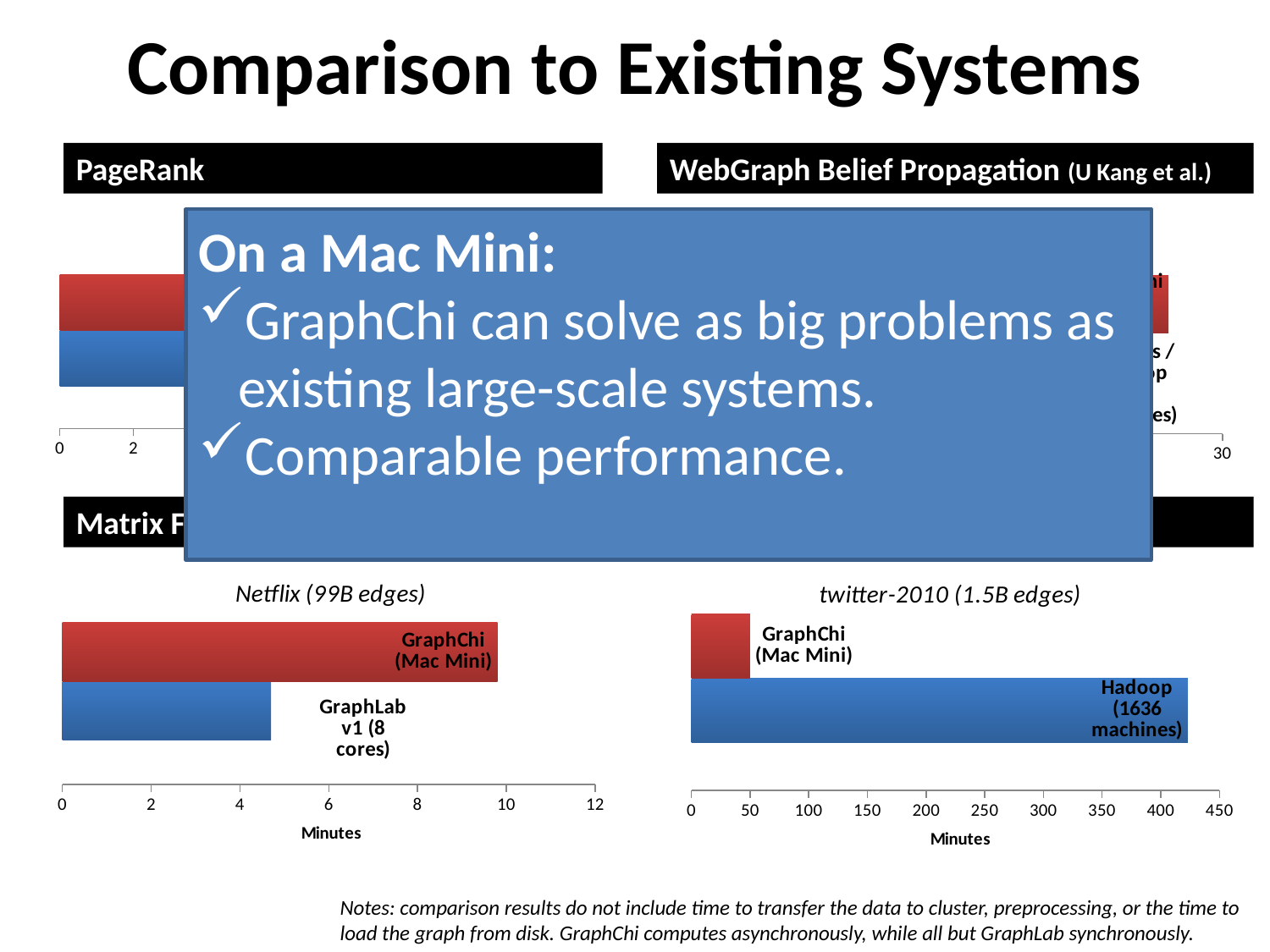
In the twitter-2010 (1.5B edges) chart, which system has the longer bar? Hadoop (1636 machines) What kind of chart is the twitter-2010 (1.5B edges) chart? bar chart In the twitter-2010 (1.5B edges) chart, is the value for GraphChi (Mac Mini) greater or less than 100 minutes? less In the Netflix (99B edges) chart, which system has the longer bar? GraphChi (Mac Mini) What is the x-axis label of the Netflix (99B edges) chart? Minutes How many bars are plotted in the Netflix (99B edges) chart? 2 In the Netflix (99B edges) chart, which system has the shorter bar? GraphLab v1 (8 cores) In the twitter-2010 (1.5B edges) chart, which is larger: the value for GraphChi (Mac Mini) or the value for Hadoop (1636 machines)? Hadoop (1636 machines) In the Netflix (99B edges) chart, is the value for GraphLab v1 (8 cores) greater or less than 6 minutes? less In the twitter-2010 (1.5B edges) chart, which system has the shorter bar? GraphChi (Mac Mini) In the Netflix (99B edges) chart, is the value for GraphChi (Mac Mini) greater or less than 8 minutes? greater